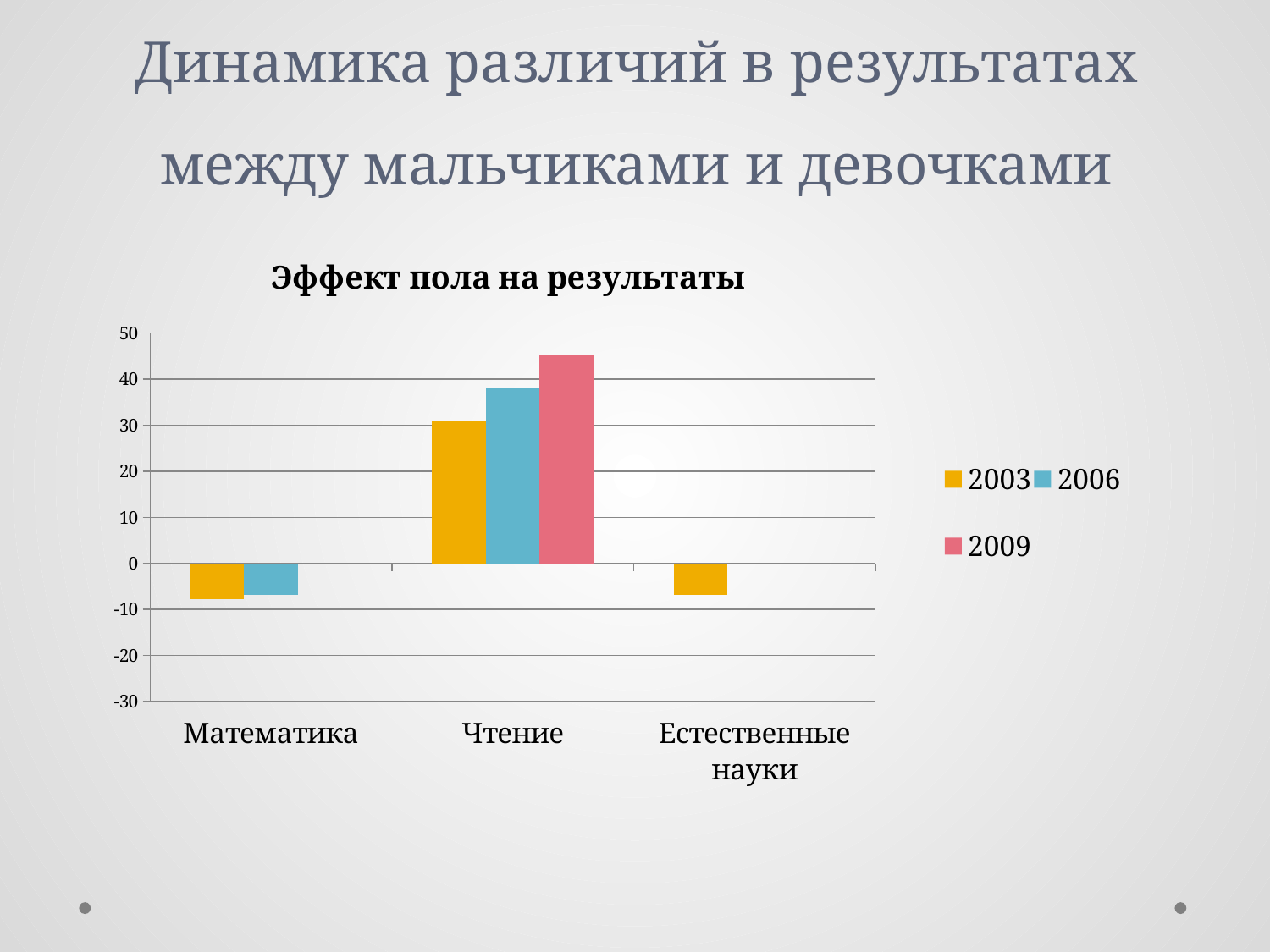
How many categories are shown on the x axis? 3 How many series does the legend list? 3 For Чтение, which year has the highest bar? 2009 Is the value for Чтение in 2003 greater or less than 40? less What kind of chart is shown on the slide? bar chart Is the value for Математика in 2003 greater or less than 0? less Is the value for Чтение in 2009 greater or less than 40? greater What is the title of the chart? Эффект пола на результаты Which category has the highest values in the chart? Чтение Do the values for Чтение rise or fall from 2003 to 2009? rise Which colour represents the 2009 series in the legend? pink/red Which is larger for Чтение: the 2006 value or the 2003 value? 2006